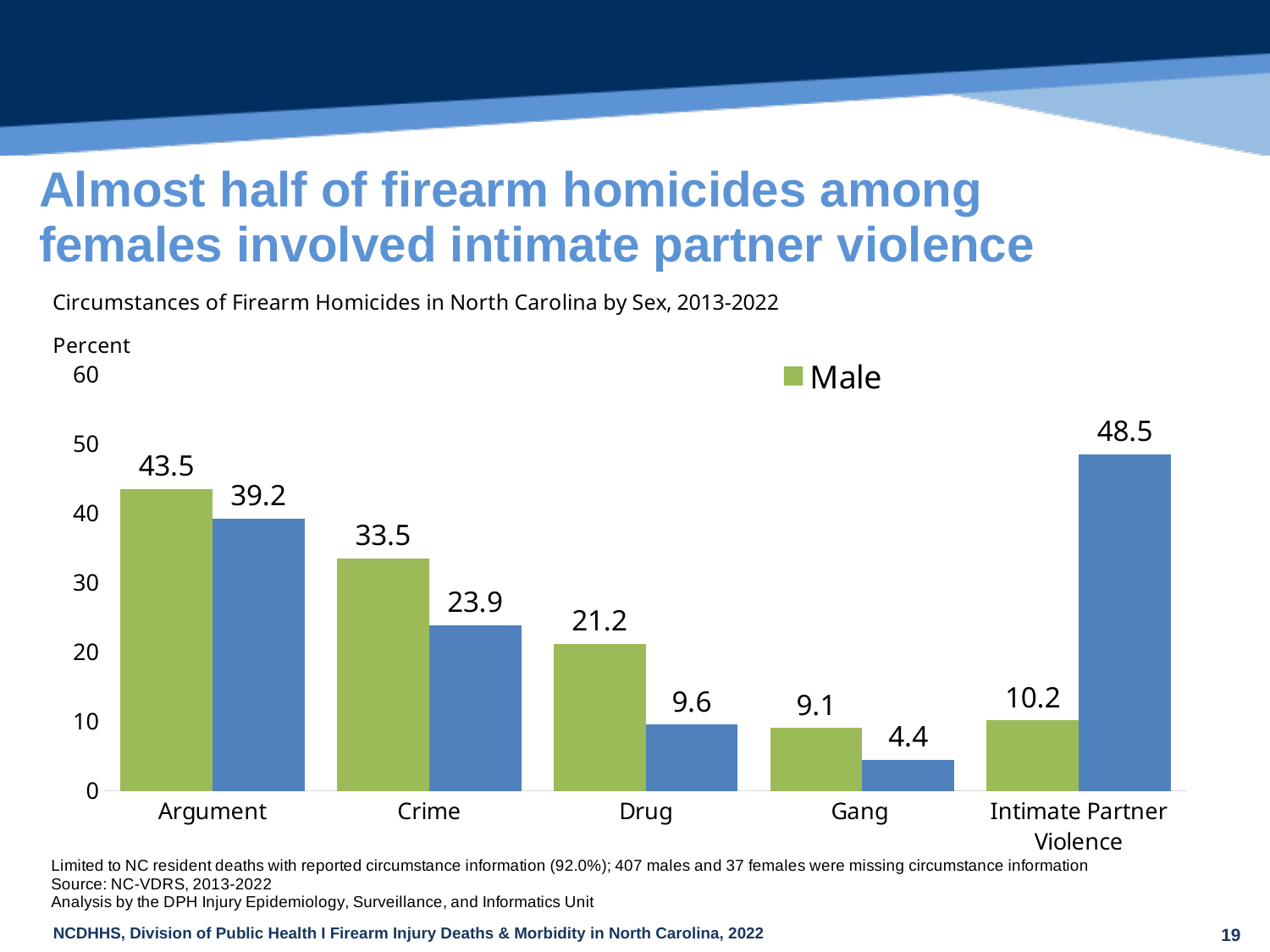
What is the value of the blue bar for Gang? 4.4 What is the Male value for Argument? 43.5 What is the label on the y axis? Percent How many series does the legend list? 1 What is the value of the blue bar for Intimate Partner Violence? 48.5 Which category has the highest Male value? Argument Which is larger for Drug: the Male value or the blue bar value? Male What is the Male value for Intimate Partner Violence? 10.2 What type of chart is shown on the slide? bar chart Which category has the lowest Male value? Gang How many categories are shown on the x axis? 5 What is the difference between the Male value for Crime and the blue bar value for Crime? 9.6